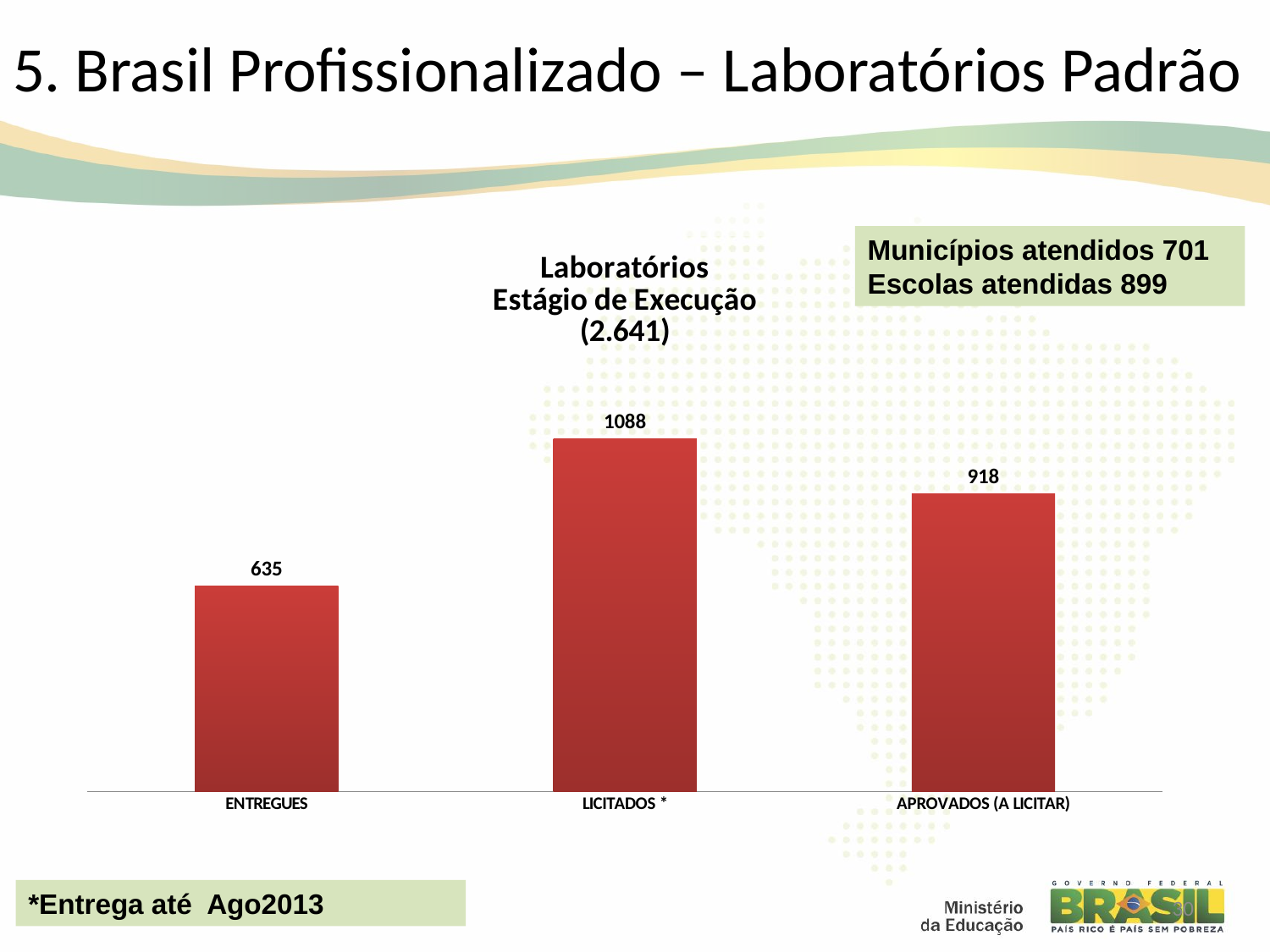
What is the total of the three bar values? 2641 What is the difference between the values for LICITADOS * and APROVADOS (A LICITAR)? 170 What is the value for APROVADOS (A LICITAR)? 918 What is the value for ENTREGUES? 635 What kind of chart is shown on the slide? bar chart Which is larger, the value for ENTREGUES or the value for APROVADOS (A LICITAR)? APROVADOS (A LICITAR) How many categories are shown in the chart? 3 Which category has the highest value? LICITADOS * Which category has the lowest value? ENTREGUES What is the difference between the values for APROVADOS (A LICITAR) and ENTREGUES? 283 What is the title of the chart? Laboratórios Estágio de Execução (2.641) What is the value for LICITADOS *? 1088